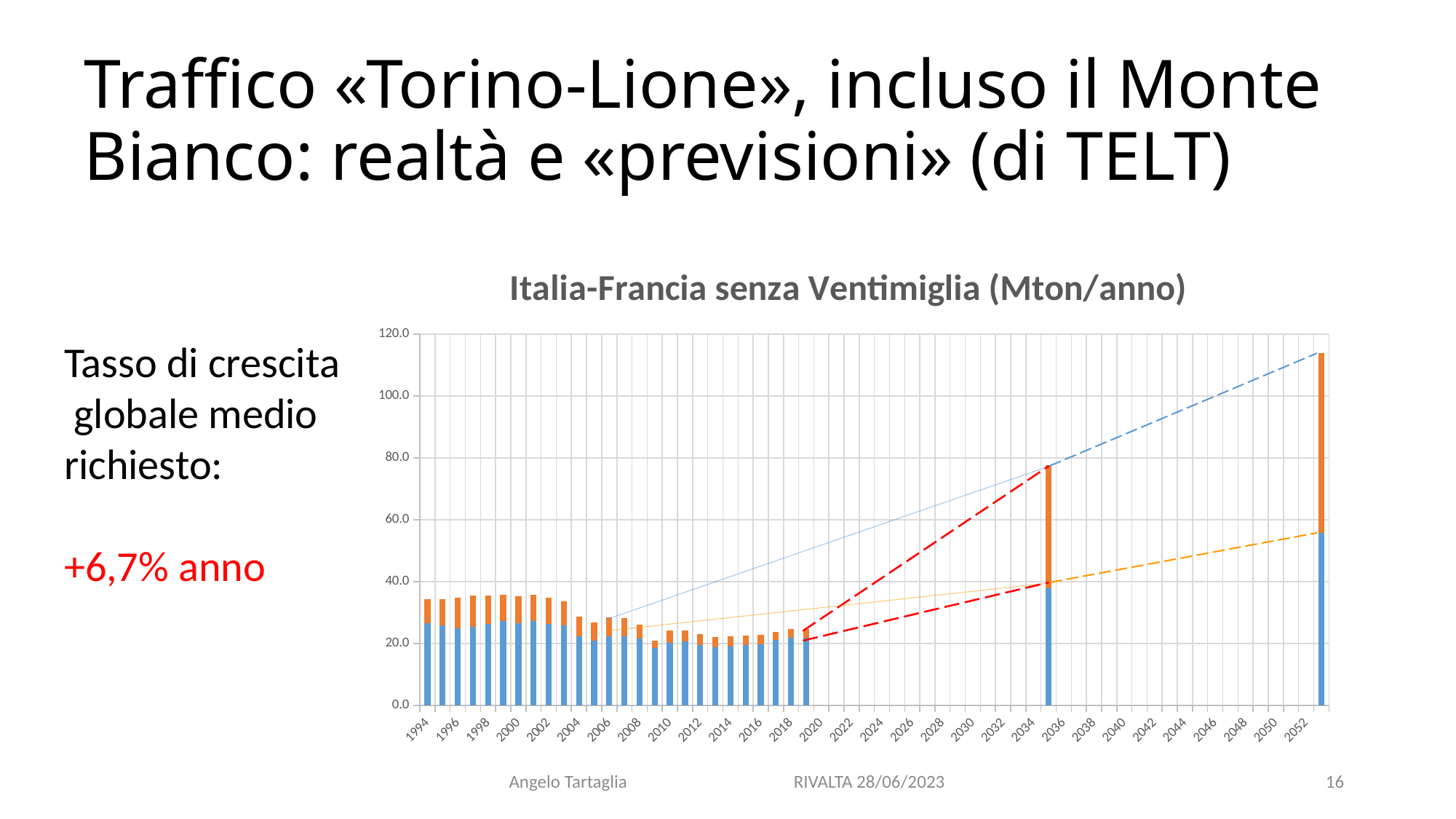
Which year has the tallest stacked bar in the chart? 2053 Is the total of the stacked bar for 1994 greater or less than 40? less Is the total of the stacked bar for 2010 greater or less than 40? less Is the total of the stacked bar for 2035 greater or less than 60? greater Do the stacked bar totals rise or fall between 2000 and 2010? fall Which stacked bar is taller, the one for 2035 or the one for 2053? 2053 What kind of chart is shown on the slide? bar chart Which stacked bar is taller, the one for 1994 or the one for 2010? 1994 What is the title of the chart? Italia-Francia senza Ventimiglia (Mton/anno) What is the highest value shown on the vertical axis? 120.0